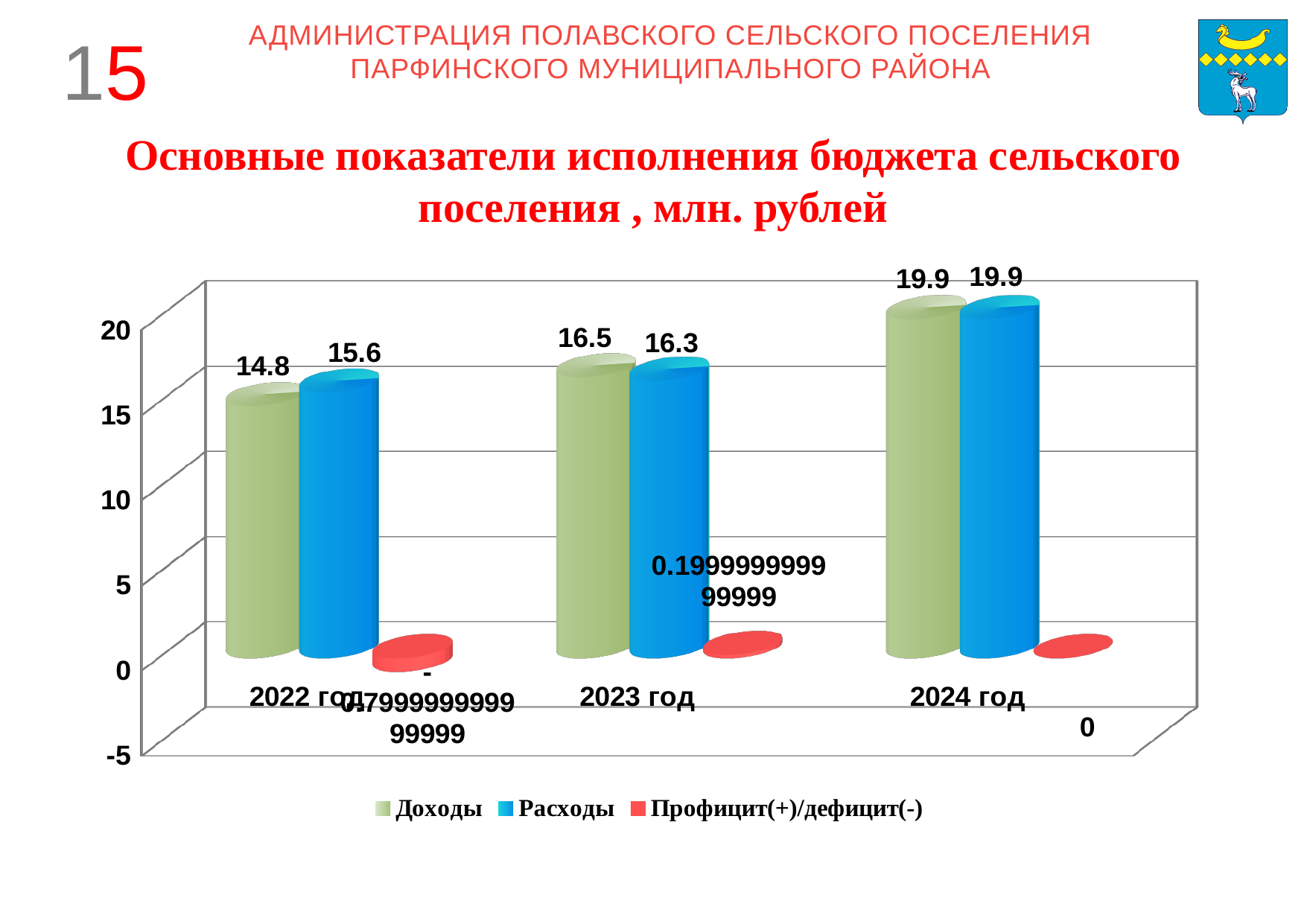
Which is larger for 2023 год, Доходы or Расходы? Доходы What is the value of Профицит(+)/дефицит(-) for 2024 год? 0 How many years are shown on the x axis? 3 Do the Доходы values rise or fall from 2022 год to 2024 год? rise In which year is Доходы the highest? 2024 год What is the value of Расходы for 2023 год? 16.3 What is the difference between Расходы and Доходы for 2022 год? 0.8 In which year is Расходы the lowest? 2022 год Is the value of Доходы for 2022 год greater or less than 15? less What is the value of Доходы for 2022 год? 14.8 How many series does the legend list? 3 What is the value of Доходы for 2024 год? 19.9